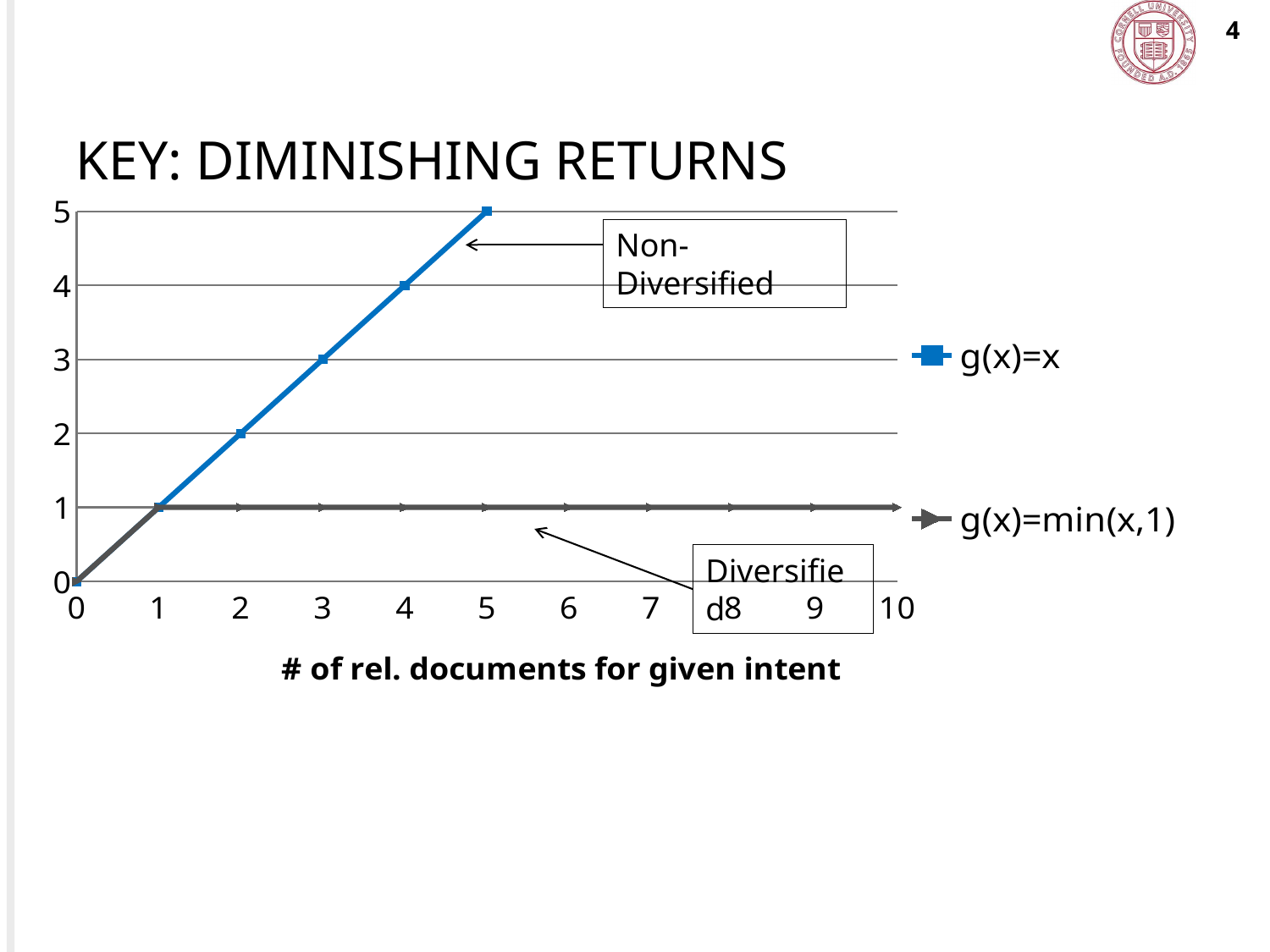
What is the value of the g(x)=x series at x = 5? 5 What is the value of the g(x)=min(x,1) series at x = 7? 1 Is the value of the g(x)=x series at x = 4 greater or less than 3? greater What is the value of the g(x)=x series at x = 3? 3 What is the x-axis title of the chart? # of rel. documents for given intent What is the difference between the g(x)=x value and the g(x)=min(x,1) value at x = 5? 4 How many series does the legend list? 2 Does the g(x)=min(x,1) series rise, fall, or stay flat between x = 1 and x = 10? stay flat Which series has the higher value at x = 4, g(x)=x or g(x)=min(x,1)? g(x)=x Does the g(x)=x series rise or fall as x increases? rise What are the two series named in the legend? g(x)=x and g(x)=min(x,1) What kind of chart is shown on the slide? line chart